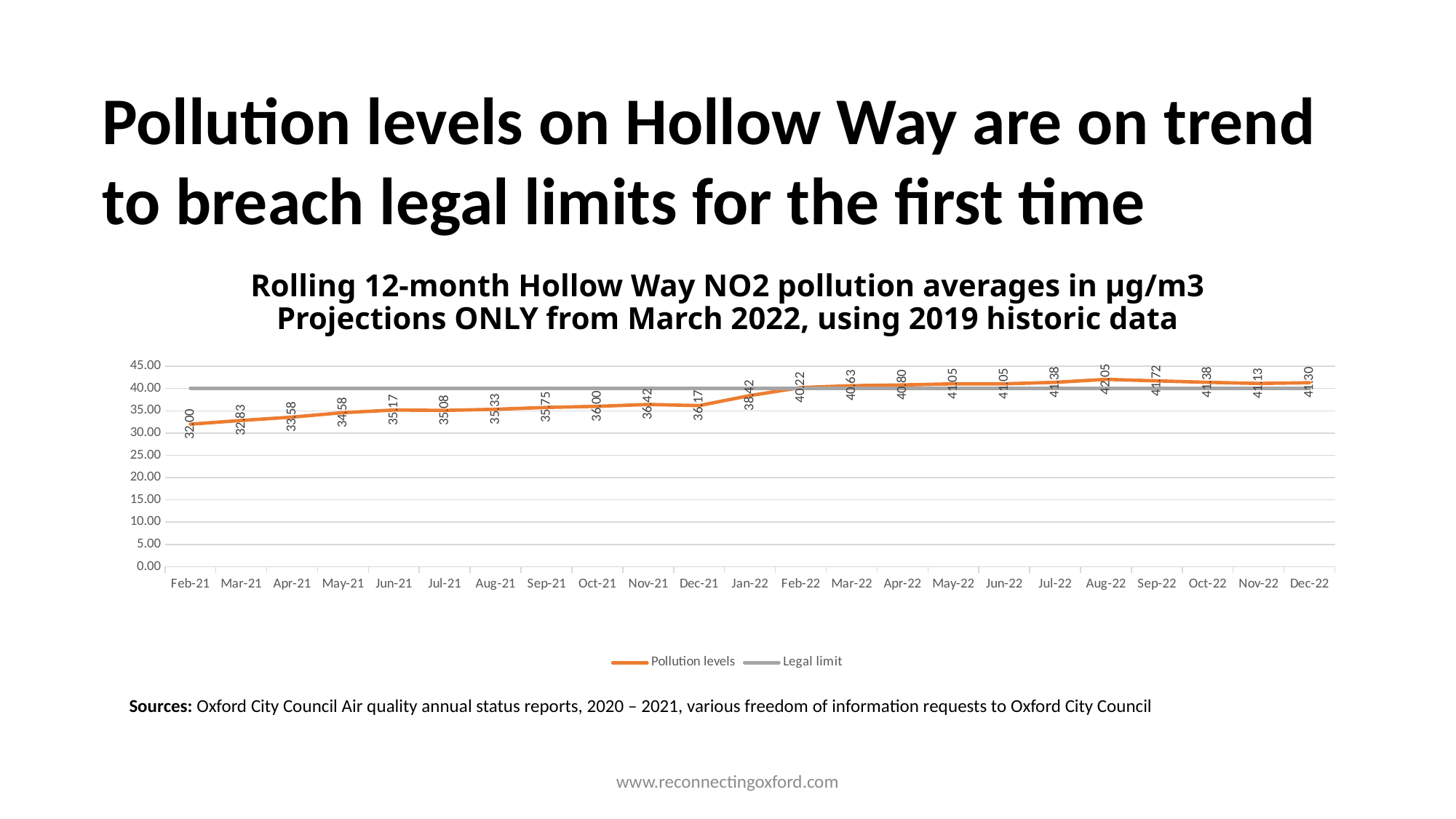
How many series does the legend list? 2 What is the pollution level value for Dec-22? 41.30 In which month does the pollution level reach its highest value? Aug-22 What is the pollution level value for Jan-22? 38.42 What type of chart is shown on the slide? line chart Is the pollution level for Dec-21 greater or less than 40.00? less In which month is the pollution level at its lowest value? Feb-21 What is the pollution level value for Feb-21? 32.00 What is the difference between the pollution level in Aug-22 and in Feb-21? 10.05 What colour is the Legal limit line? grey Which is larger, the pollution level in Nov-21 or in Dec-21? Nov-21 How many months are plotted on the x axis? 23